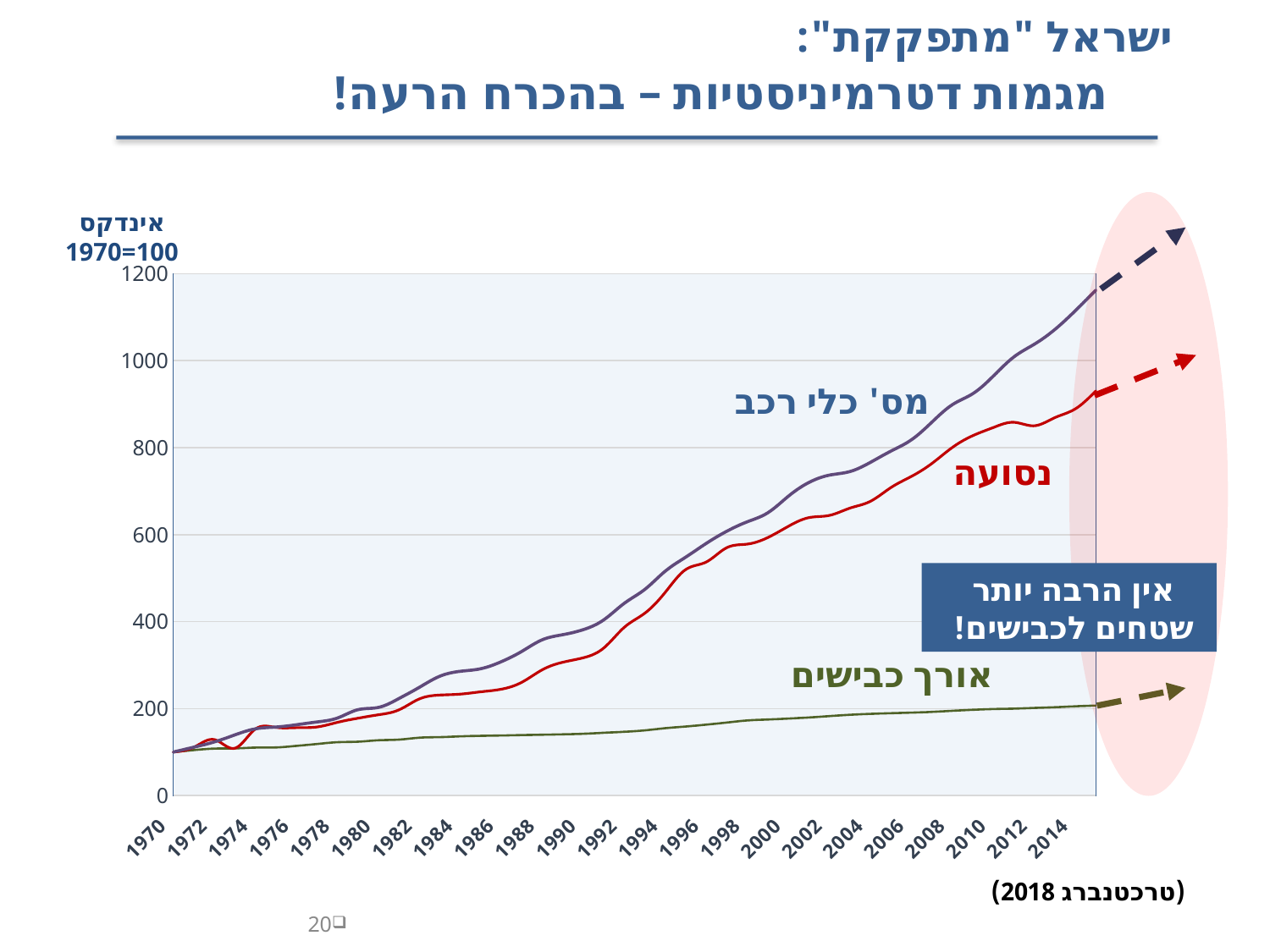
Is the value for מס' כלי רכב in 2014 greater or less than 1000? greater How many year labels are shown on the x axis? 23 What kind of chart is shown on the slide? line chart How many data series are plotted on the chart? 3 Which series has the lowest value at the right end of the chart (around 2014)? אורך כבישים In 2010, which series is larger: מס' כלי רכב or נסועה? מס' כלי רכב What base year and value does the index on the y axis use? 1970=100 Is the value for אורך כבישים in 2014 greater or less than 400? less Which series has the highest value at the right end of the chart (around 2014)? מס' כלי רכב Do the values of the מס' כלי רכב series rise or fall from 1970 to 2014? rise Is the value for נסועה in 2014 greater or less than 1000? less